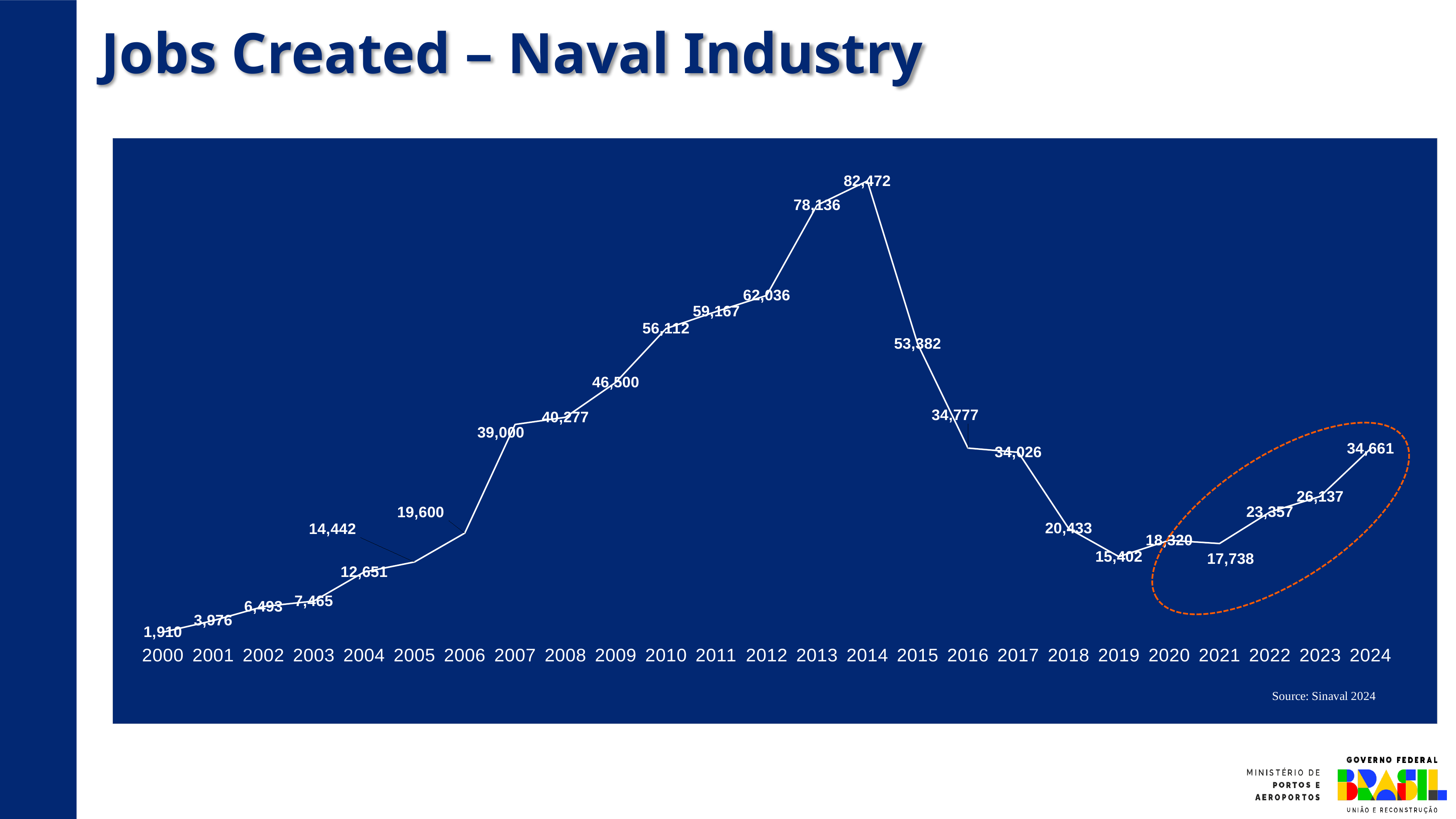
Which year has a larger value, 2015 or 2016? 2015 What is the value shown for 2007? 39,000 Do the values rise or fall from 2019 to 2024? Rise Which year has the highest number of jobs created? 2014 What is the value shown for 2000? 1,910 What is the difference between the values for 2014 and 2013? 4,336 Which year has the lowest number of jobs created? 2000 How many jobs were created in the naval industry in 2014? 82,472 What is the difference between the values for 2024 and 2023? 8,524 How many years are plotted on the x axis? 25 What type of chart is shown on the slide? Line chart What is the value shown for 2024? 34,661